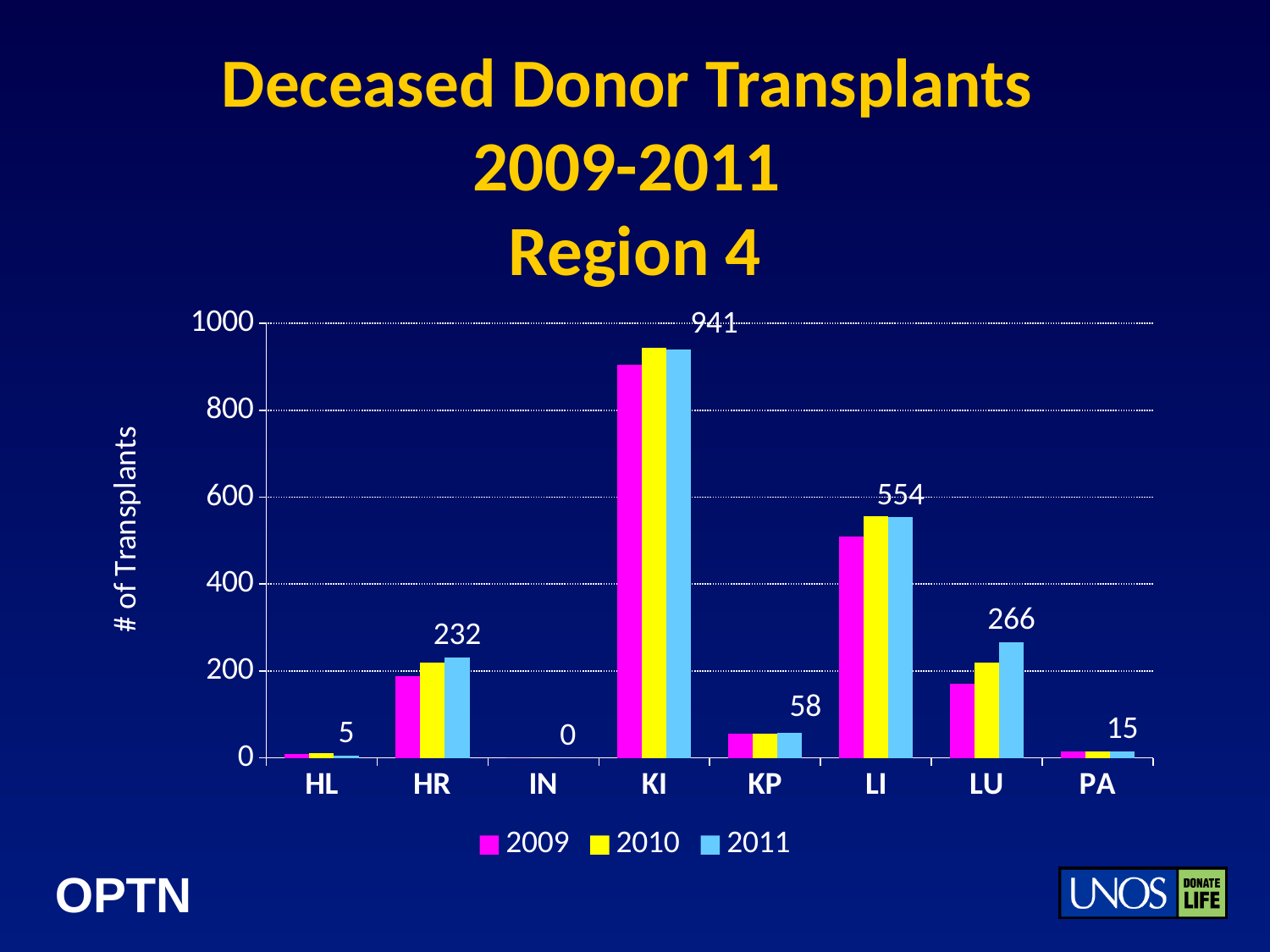
What is the number of transplants for HR in 2011? 232 What type of chart is shown on the slide? bar chart What is the number of transplants for LI in 2011? 554 What is the number of transplants for LU in 2011? 266 What is the difference between the 2011 values for KI and LI? 387 What is the number of transplants for KI in 2011? 941 How many organ categories are shown on the x axis? 8 How many series does the legend list? 3 Is the 2009 value for LI greater or less than 400? greater Which organ category has the highest number of transplants in 2011? KI Which is larger, the 2011 value for KP or the 2011 value for PA? KP What is the number of transplants for IN in 2011? 0